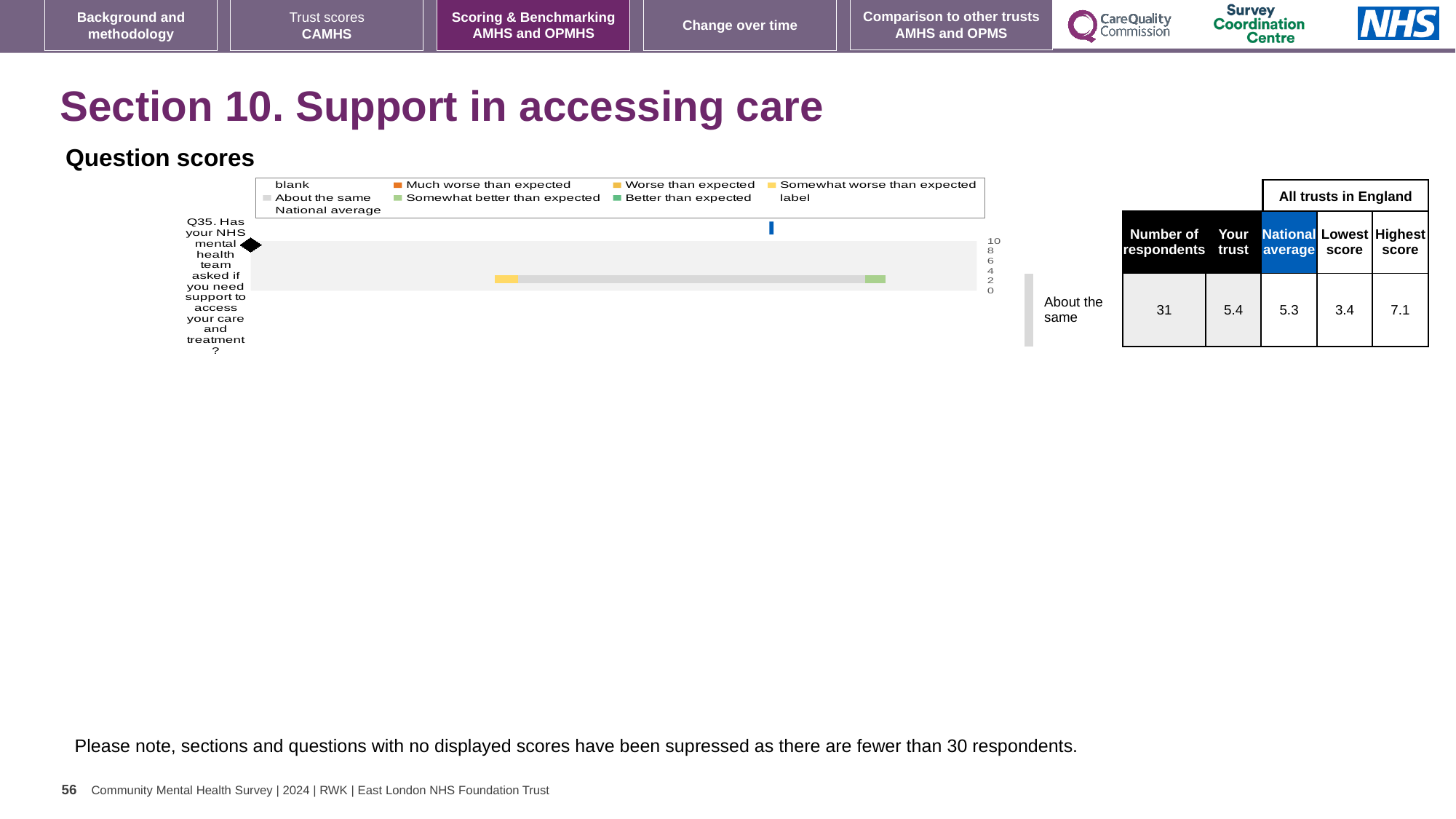
What is the highest value shown on the score axis of the Question scores chart? 10 What is the national average score for Q35? 5.3 What kind of chart is shown under 'Question scores'? bar chart How many questions (categories) are plotted in the Question scores chart? 1 How many respondents answered Q35? 31 How is the trust's result for Q35 categorised relative to other trusts? About the same What is the highest score among all trusts in England for Q35? 7.1 Which is larger for Q35, the 'Your trust' score or the national average? Your trust What is the lowest score among all trusts in England for Q35? 3.4 Which question is plotted in the Question scores chart? Q35. Has your NHS mental health team asked if you need support to access your care and treatment? What is the 'Your trust' score for Q35? 5.4 What is the difference between the highest and lowest scores for Q35 across all trusts in England? 3.7